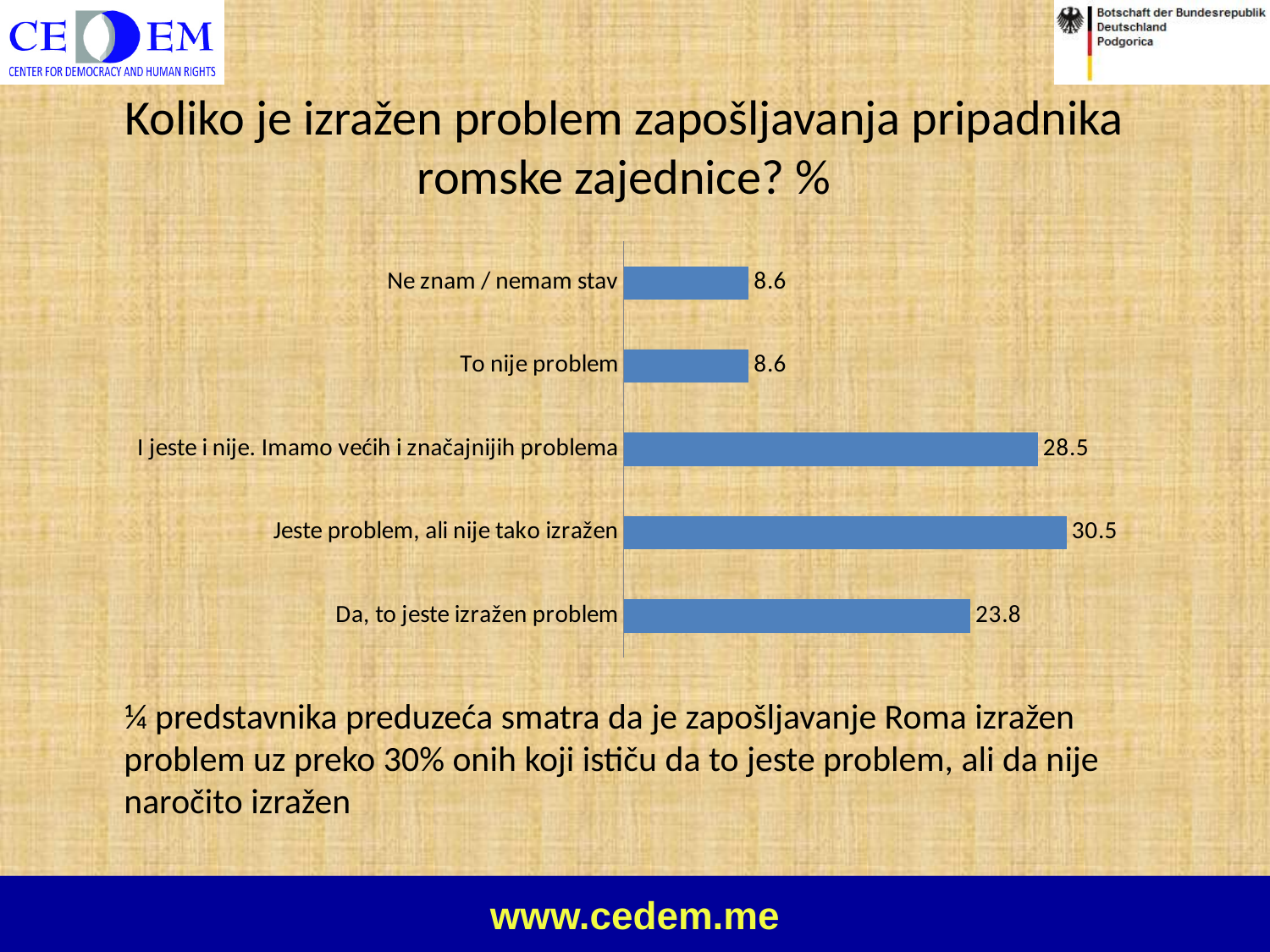
Which is larger: the value for "Da, to jeste izražen problem" or the value for "I jeste i nije. Imamo većih i značajnijih problema"? I jeste i nije. Imamo većih i značajnijih problema How many categories are shown in the chart? 5 What is the value for "Da, to jeste izražen problem"? 23.8 What is the value for "I jeste i nije. Imamo većih i značajnijih problema"? 28.5 What is the value for "Jeste problem, ali nije tako izražen"? 30.5 What is the value for "To nije problem"? 8.6 What is the title of the chart on the slide? Koliko je izražen problem zapošljavanja pripadnika romske zajednice? % Which two categories share the same value? Ne znam / nemam stav and To nije problem What is the difference between the values for "Jeste problem, ali nije tako izražen" and "Da, to jeste izražen problem"? 6.7 What is the difference between the values for "I jeste i nije. Imamo većih i značajnijih problema" and "To nije problem"? 19.9 Which category has the highest value? Jeste problem, ali nije tako izražen What kind of chart is shown on the slide? Bar chart